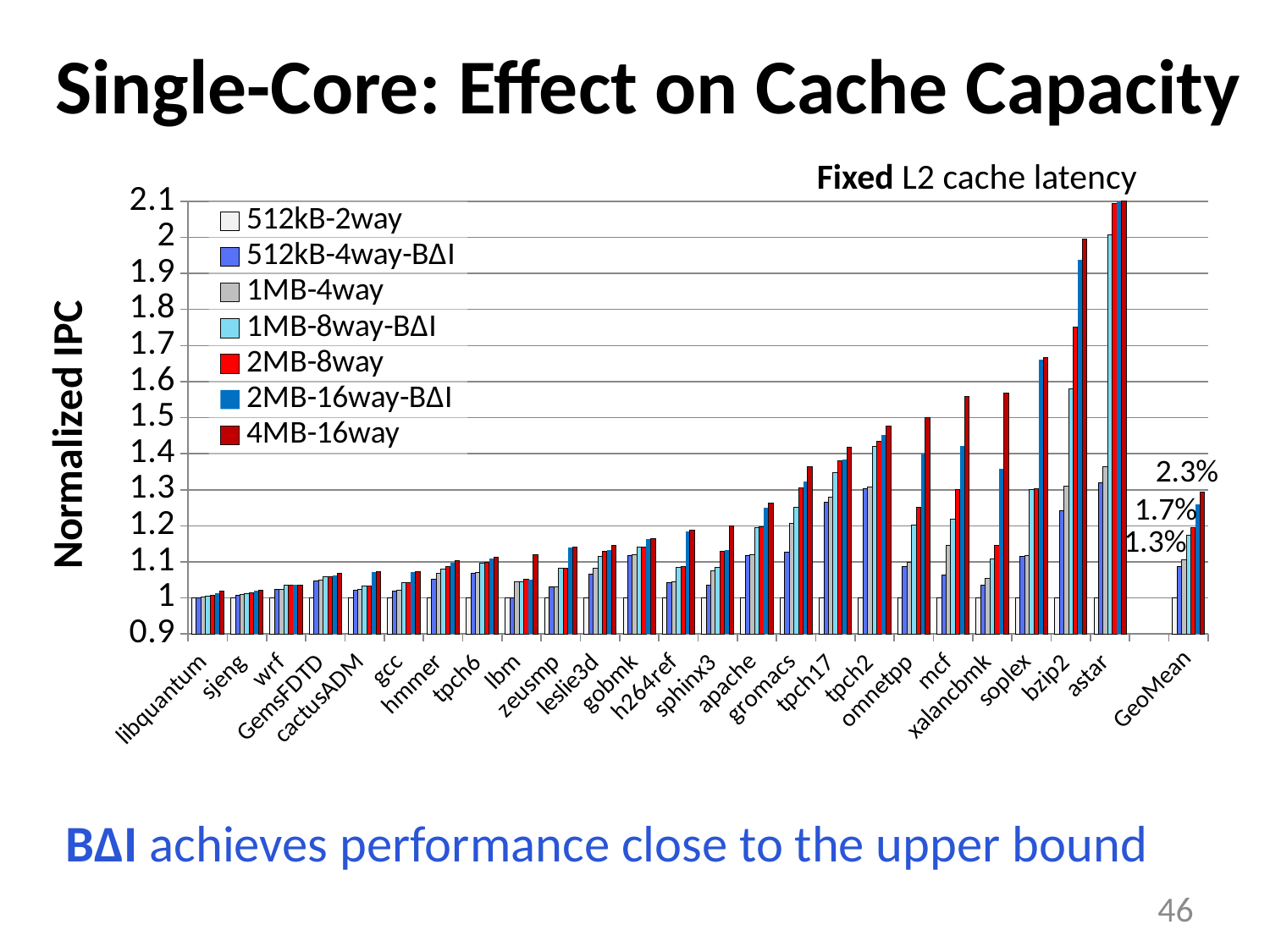
Is the 512kB-2way value for libquantum greater or less than 1.1? less How many categories are shown along the x axis, including GeoMean? 25 What kind of chart is shown on the slide? bar chart Which has the larger 4MB-16way value, soplex or gcc? soplex Is the 4MB-16way value for mcf greater or less than 1.5? greater Which benchmark has the highest normalized IPC values? astar Which benchmark has the lowest normalized IPC values? libquantum Is the 4MB-16way value for soplex greater or less than 1.6? greater What is the label on the y axis of the chart? Normalized IPC How many series does the legend list? 7 Do the normalized IPC values generally rise or fall moving from libquantum to astar along the x axis? rise